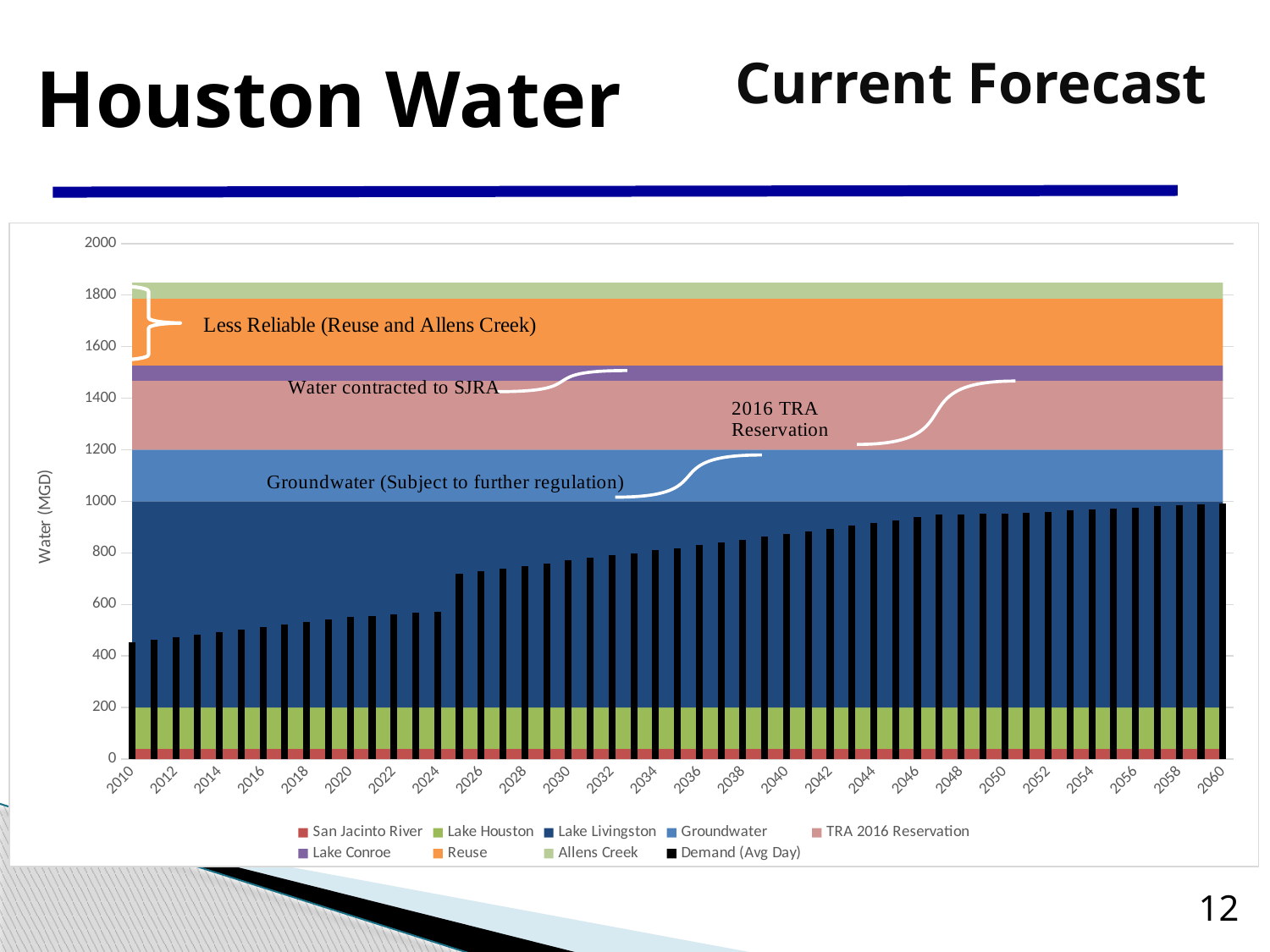
What is the label on the vertical axis? Water (MGD) In which year is the Demand (Avg Day) bar lowest? 2010 Is the Demand (Avg Day) value for 2050 greater or less than 800? greater Is the Demand (Avg Day) value for 2020 greater or less than 800? less Is the Demand (Avg Day) value for 2030 greater or less than 600? greater Which year has the larger Demand (Avg Day) value, 2020 or 2040? 2040 In which year is the Demand (Avg Day) bar highest? 2060 Does the Demand (Avg Day) series rise or fall from 2010 to 2060? rise How many series does the legend list? 9 Which series is drawn as black vertical bars? Demand (Avg Day)